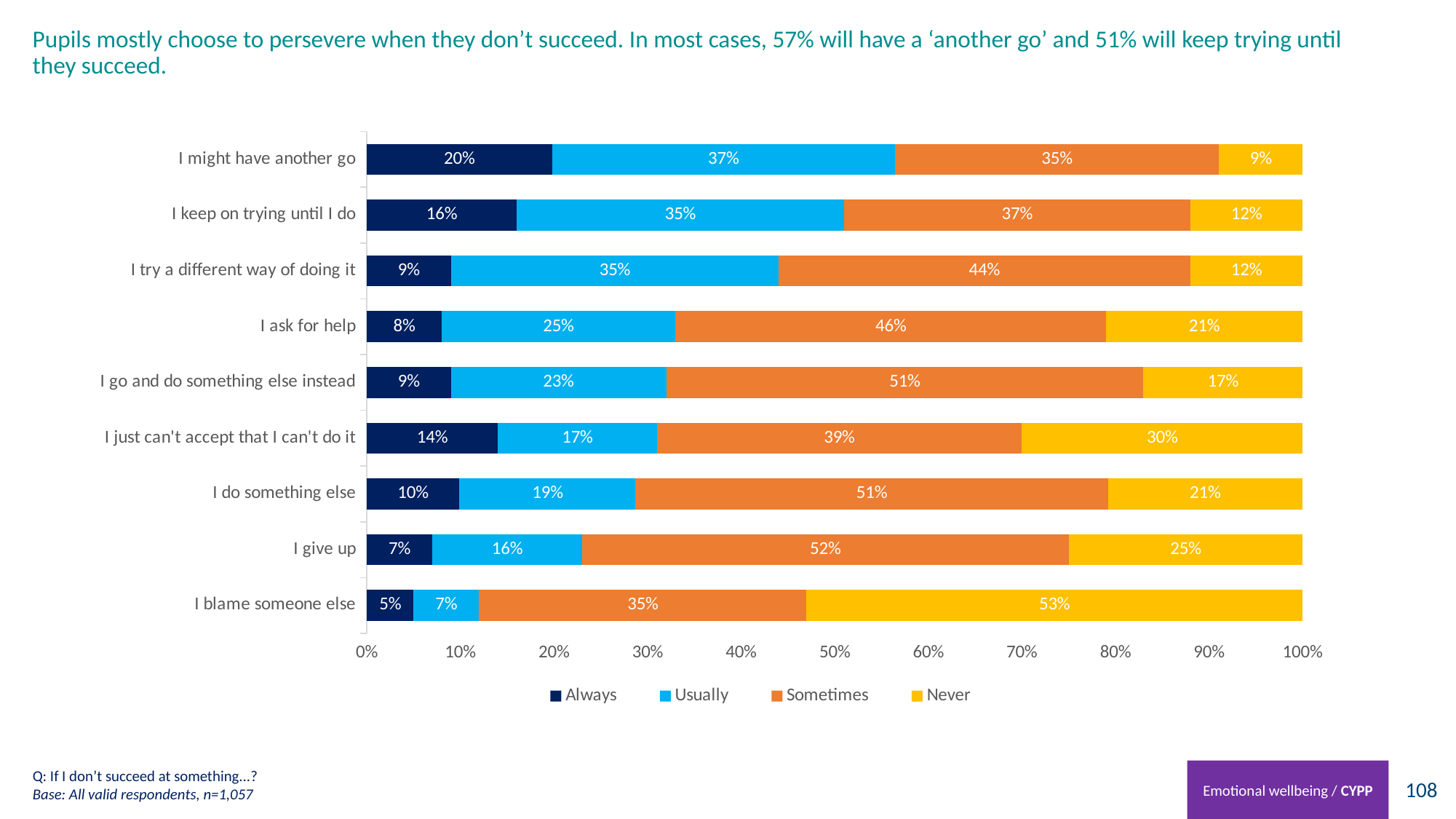
What is the difference between the 'Never' values for 'I blame someone else' and 'I might have another go'? 44% What is the combined 'Always' and 'Usually' share for 'I keep on trying until I do'? 51% Which category has the lowest 'Usually' value? I blame someone else How many categories are shown on the chart? 9 Which is larger: the 'Sometimes' value for 'I ask for help' or for 'I keep on trying until I do'? I ask for help What is the 'Never' value for 'I blame someone else'? 53% What is the 'Sometimes' value for 'I give up'? 52% What kind of chart is shown on the slide? Stacked bar chart How many series does the legend list? 4 What is the 'Usually' value for 'I try a different way of doing it'? 35% What percentage of pupils say they 'Always' might have another go? 20% Which category has the highest 'Always' value? I might have another go